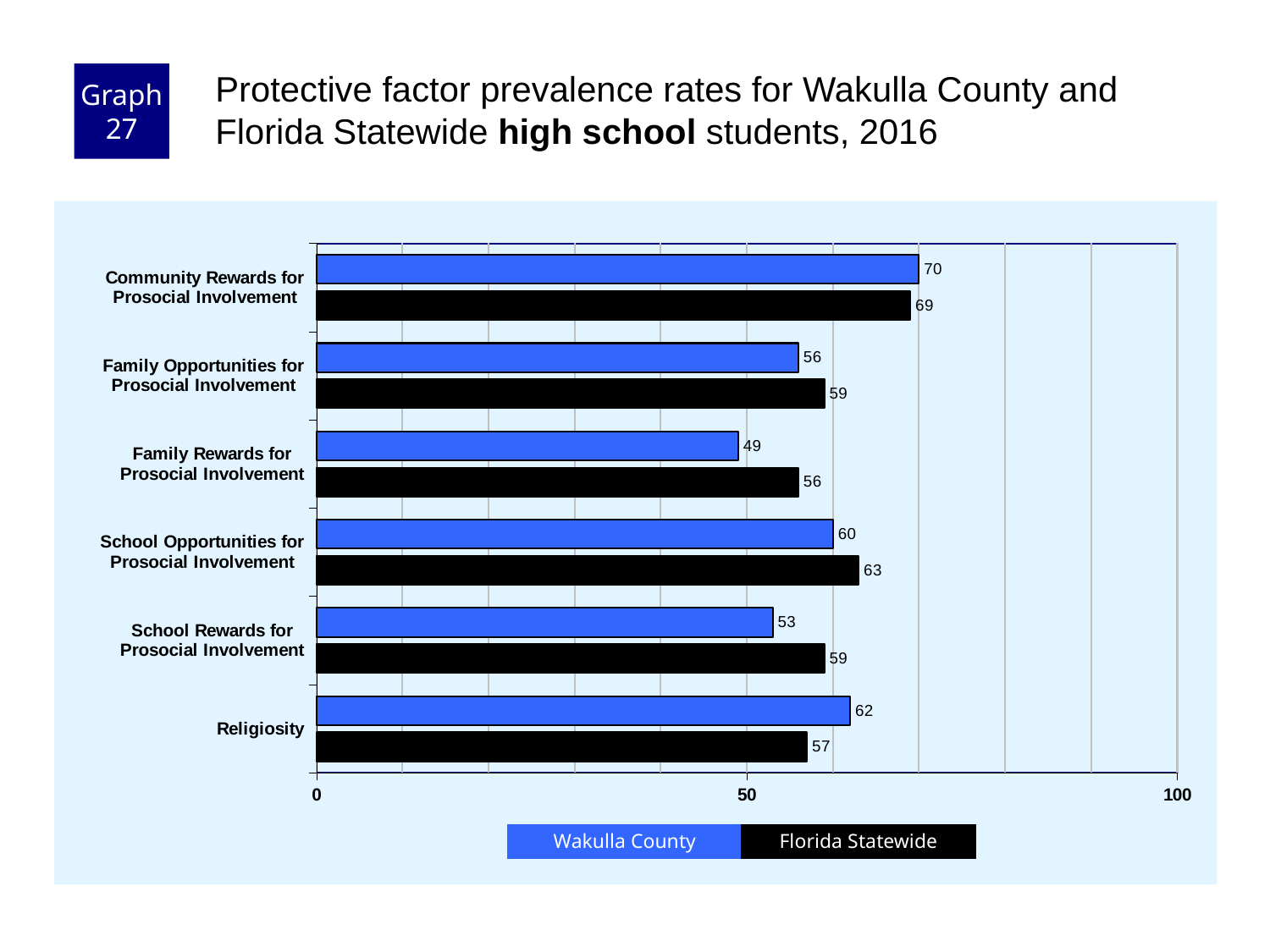
How many series does the legend list? 2 What is the Wakulla County value for Community Rewards for Prosocial Involvement? 70 For Religiosity, which is larger: the Wakulla County value or the Florida Statewide value? Wakulla County Which colour represents Florida Statewide in the chart? black Which category has the highest Wakulla County value? Community Rewards for Prosocial Involvement What is the difference between the Florida Statewide and Wakulla County values for School Rewards for Prosocial Involvement? 6 How many categories are shown on the chart? 6 Which category has the lowest Wakulla County value? Family Rewards for Prosocial Involvement What is the Wakulla County value for Religiosity? 62 Is the Wakulla County value for Family Rewards for Prosocial Involvement greater or less than 50? less What kind of chart is shown on the slide? bar chart What is the Florida Statewide value for Family Rewards for Prosocial Involvement? 56